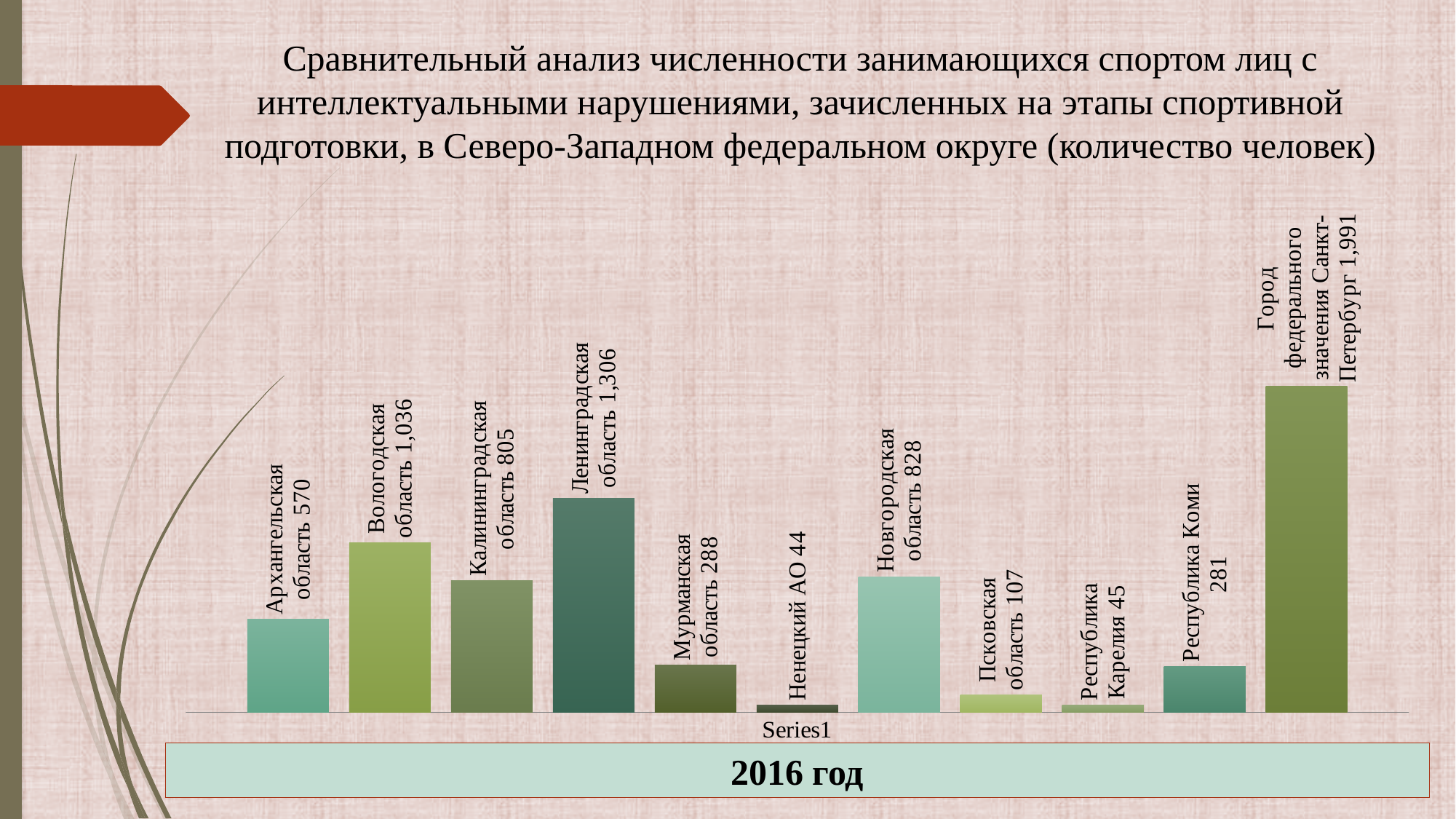
What is the x-axis label shown under the bars? Series1 What is the value for Ненецкий АО? 44 Which region has the lowest value in the chart? Ненецкий АО What is the difference between the values for Санкт-Петербург and Ленинградская область? 685 What is the difference between the values for Вологодская область and Калининградская область? 231 Which region has the highest value in the chart? Город федерального значения Санкт-Петербург What type of chart is shown on the slide? bar chart Which is larger, the value for Новгородская область or the value for Калининградская область? Новгородская область What is the value for Республика Коми? 281 What year is indicated in the box below the chart? 2016 год What is the value for Ленинградская область? 1,306 How many bars (regions) are plotted in the chart? 11